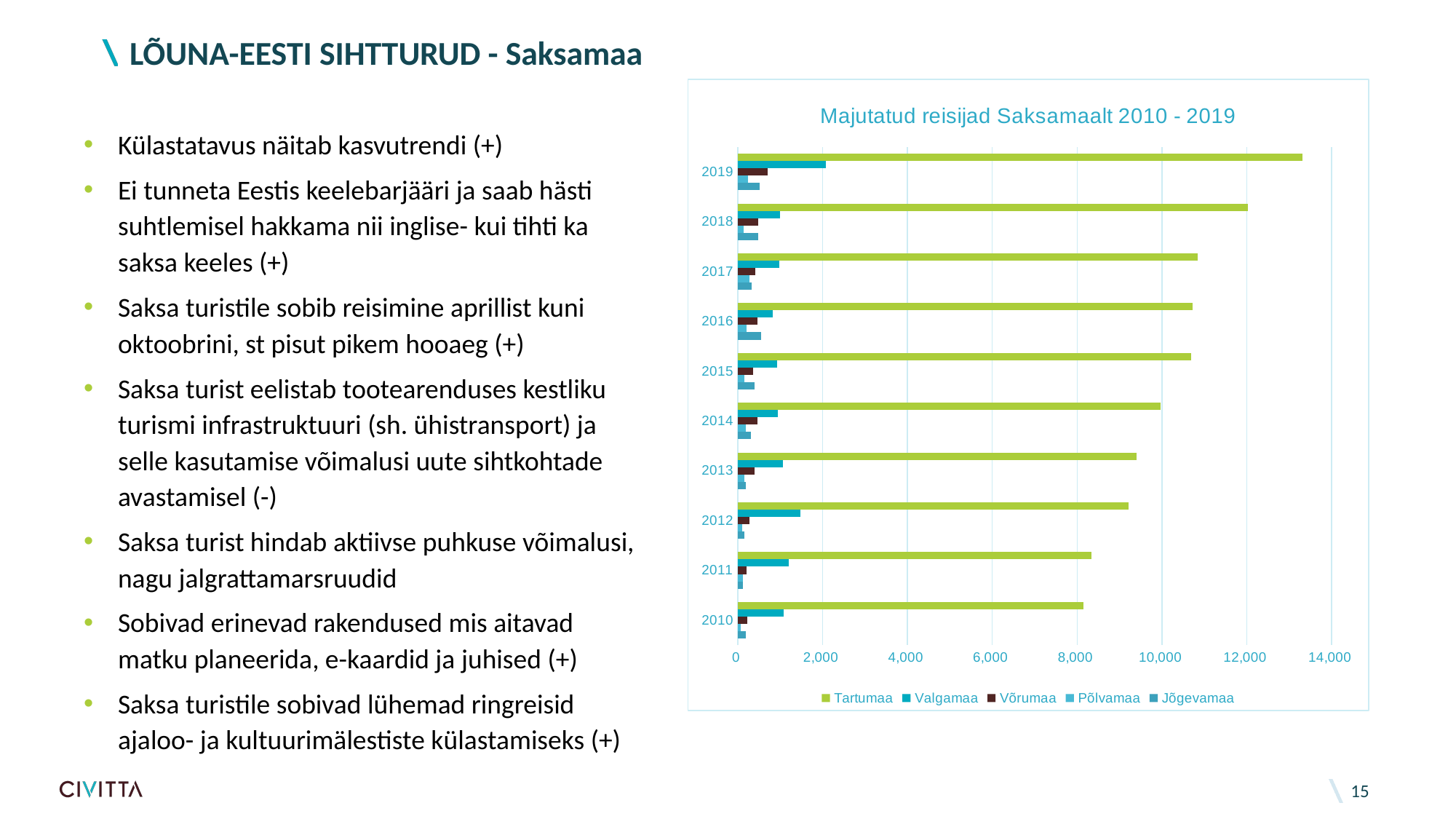
How many years are shown on the chart's vertical axis? 10 Is the Tartumaa value for 2010 greater or less than 8,000? greater In which year is the Tartumaa value lowest? 2010 How many series does the chart legend list? 5 Which is larger, the Tartumaa value for 2019 or for 2018? 2019 What kind of chart is shown on the slide? bar chart Is the Tartumaa value for 2012 greater or less than 10,000? less In which year is the Tartumaa value highest? 2019 What is the title of the chart? Majutatud reisijad Saksamaalt 2010 - 2019 Does the Tartumaa value generally rise or fall from 2010 to 2019? rise Is the Tartumaa value for 2019 greater or less than 12,000? greater Which series is shown in green in the legend? Tartumaa